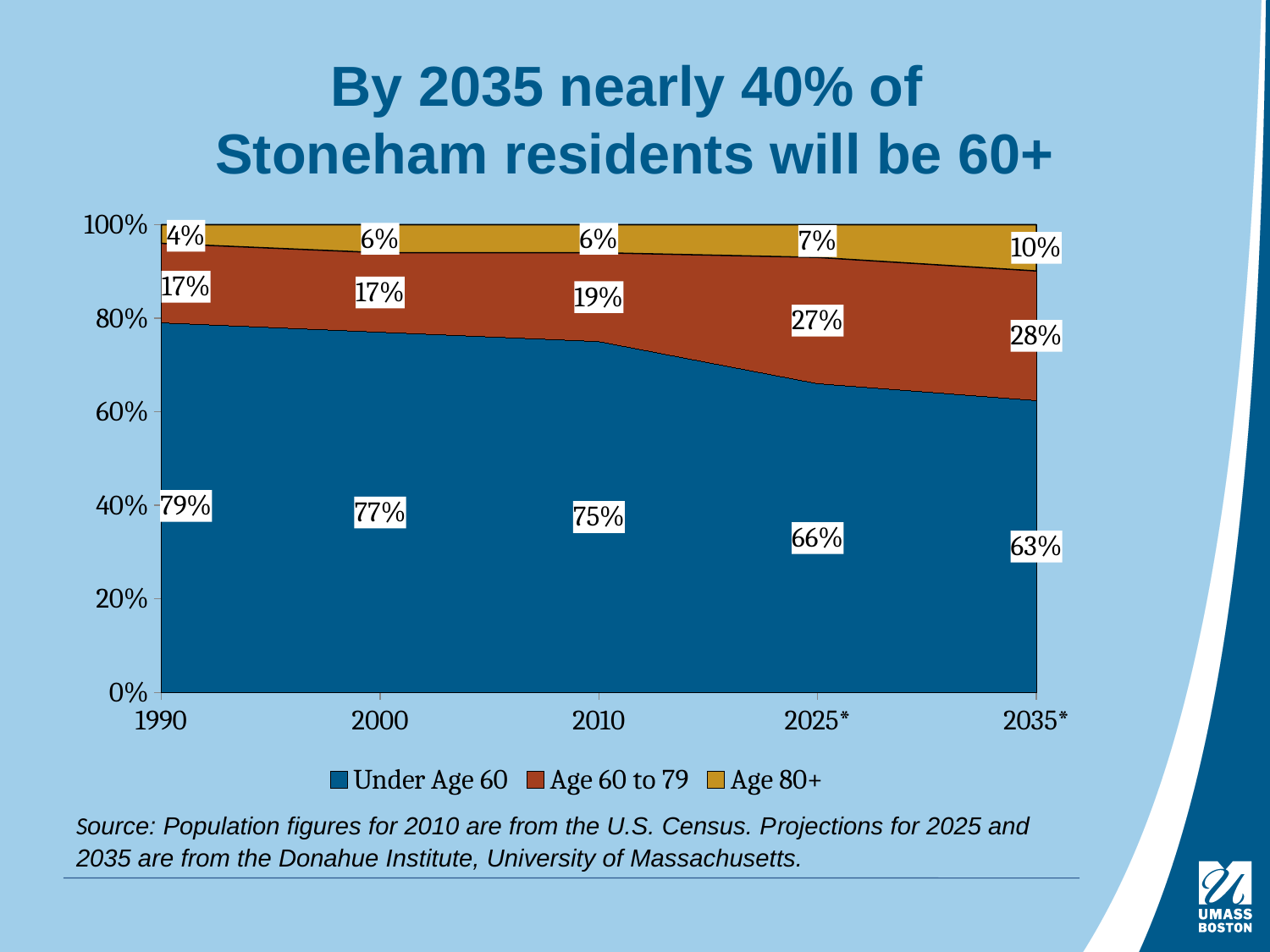
What is the combined share of residents aged 60+ (Age 60 to 79 plus Age 80+) in 2035*? 38% What is the projected share of residents aged 60 to 79 in 2035*? 28% In which year is the Under Age 60 share lowest? 2035* How many series does the legend list? 3 What percentage of Stoneham residents were under age 60 in 1990? 79% What percentage of residents were age 80+ in 2010? 6% By how many percentage points does the Under Age 60 share fall from 1990 to 2035*? 16 Does the Under Age 60 share rise or fall from 1990 to 2035*? Fall Which is larger: the Age 60 to 79 share in 2010 or in 2025*? 2025* How many years are shown on the x axis? 5 What kind of chart is shown on the slide? Stacked area chart In which year is the Age 80+ share highest? 2035*